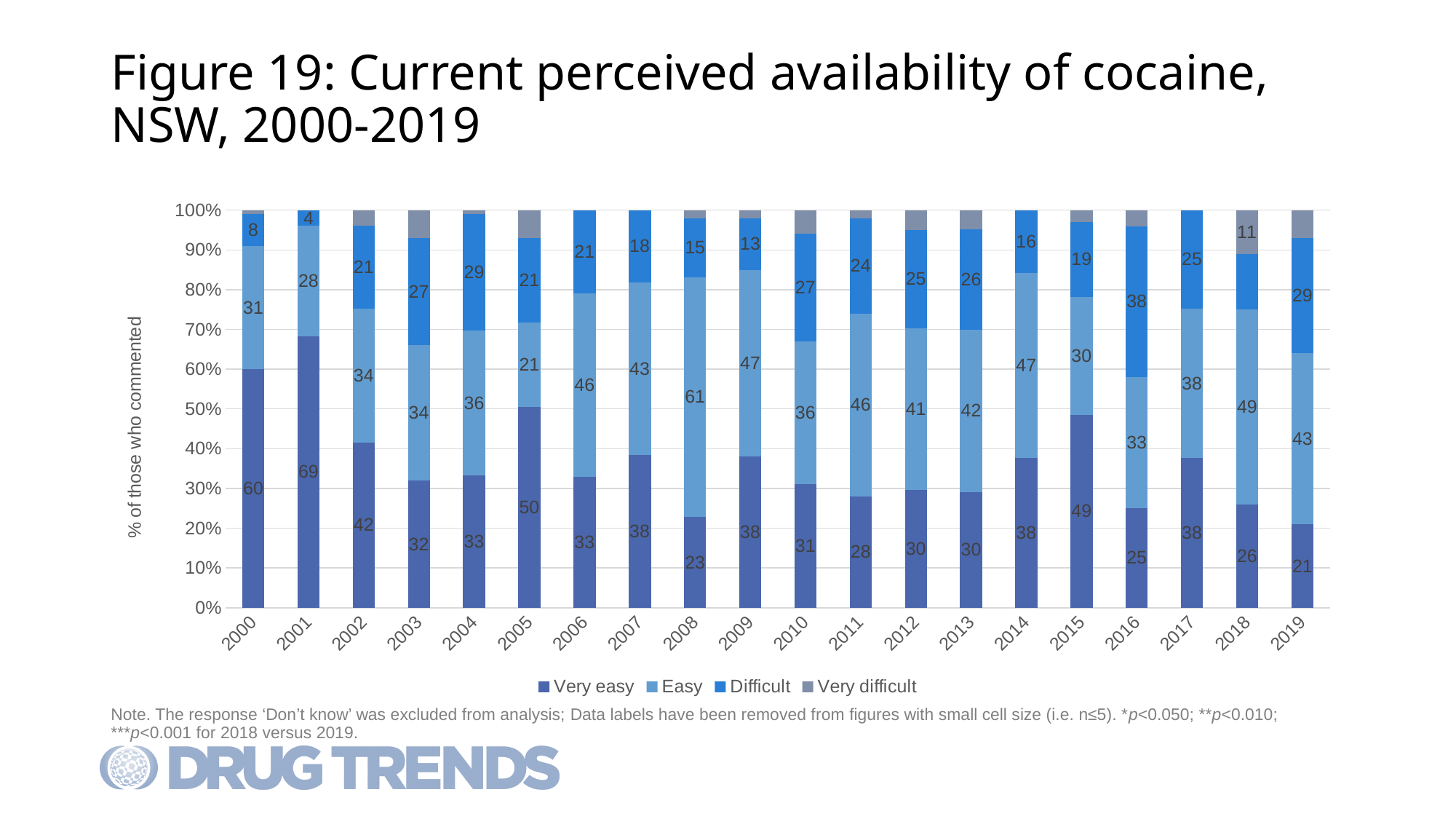
What kind of chart is shown on the slide? Stacked bar chart In which year is the 'Very easy' value highest? 2001 Which is larger, the 'Easy' value for 2018 or the 'Easy' value for 2019? 2018 What is the 'Easy' value for 2008? 61 What is the 'Difficult' value for 2016? 38 How many years are shown on the x axis? 20 What percentage of respondents rated cocaine as 'Very easy' to obtain in 2001? 69 Is the 'Very easy' segment for 2005 greater or less than 40%? greater How many series does the legend list? 4 What is the label of the y axis? % of those who commented What is the difference between the 'Very easy' values for 2015 and 2016? 24 In which year is the 'Very easy' value lowest? 2019